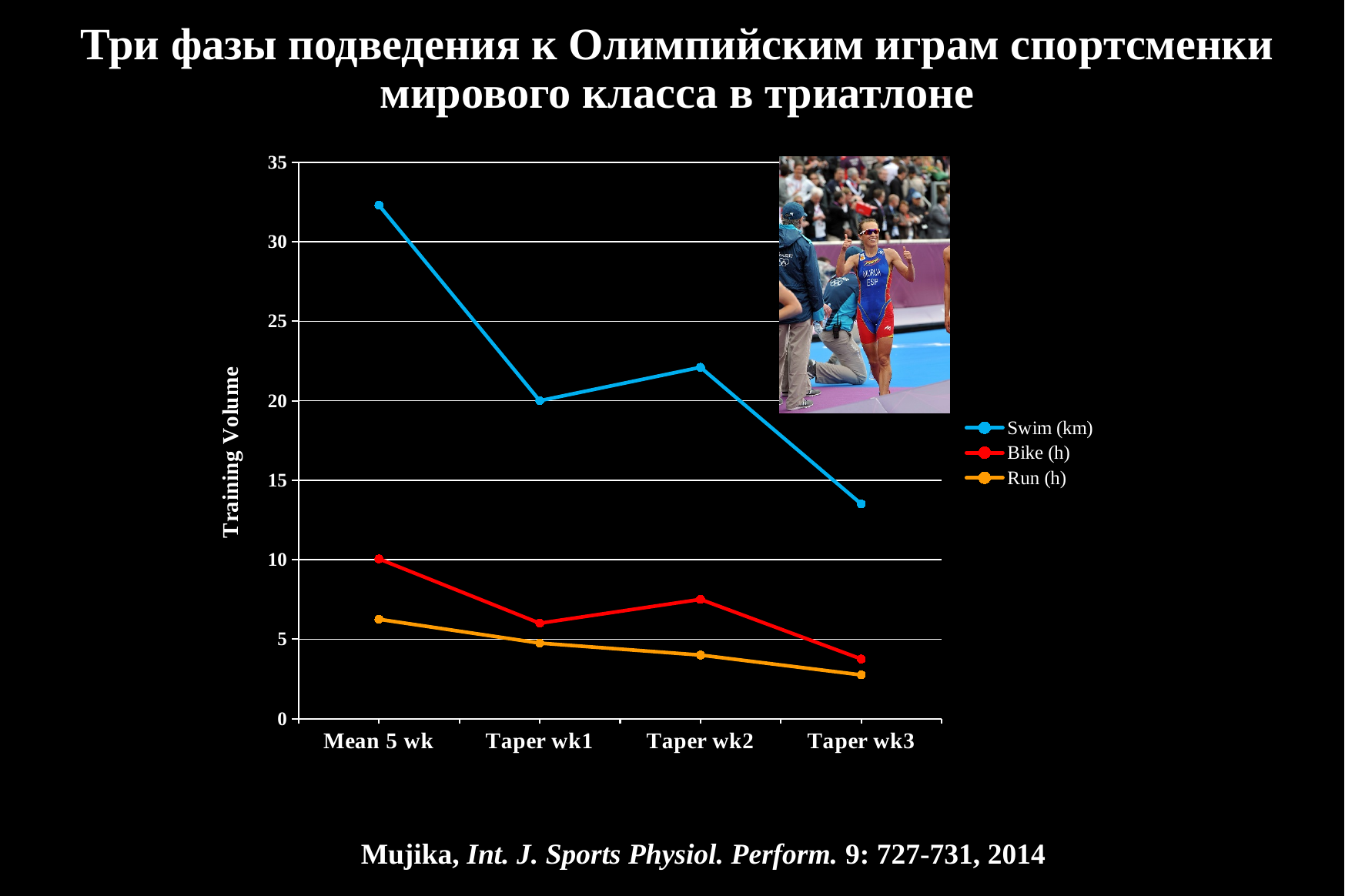
What is the label of the y axis? Training Volume At which category is the Bike (h) series lowest? Taper wk3 How many categories are shown on the x axis? 4 How many series does the legend list? 3 What kind of chart is shown on the slide? line chart Is the Swim (km) value at Mean 5 wk greater or less than 30? greater At which category is the Swim (km) series highest? Mean 5 wk What is the Swim (km) value at Taper wk1? 20 Is the Swim (km) value at Taper wk3 greater or less than 15? less Which is larger at Taper wk2: the Swim (km) value or the Bike (h) value? Swim (km) Is the Run (h) value at Taper wk3 greater or less than 5? less